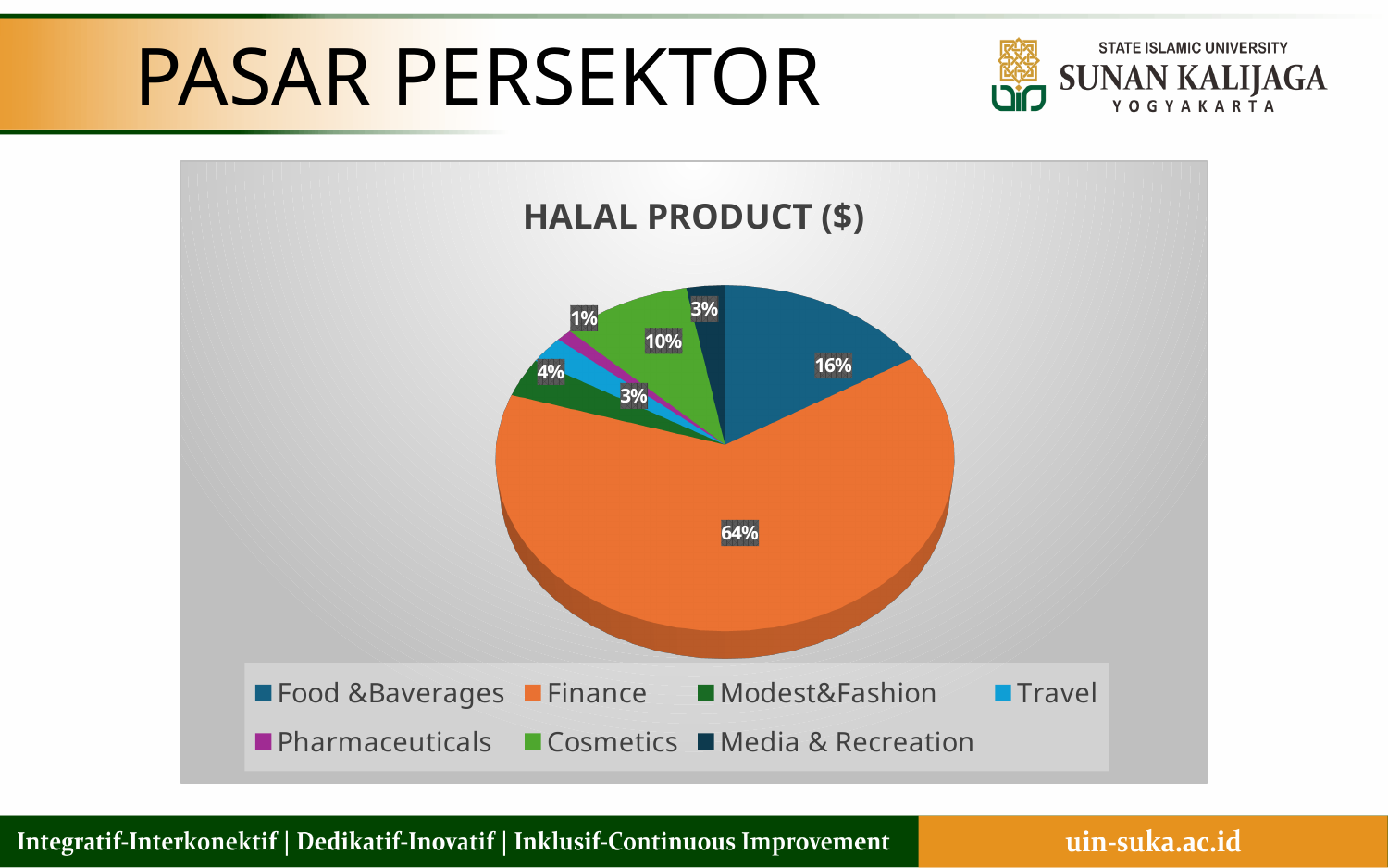
What share of the pie does Food &Baverages have? 16% Which category has the largest slice of the pie? Finance What share of the pie does Finance have? 64% What share of the pie does Cosmetics have? 10% What is the difference in percentage points between Finance and Food &Baverages? 48 Which is larger, the share for Cosmetics or the share for Modest&Fashion? Cosmetics How many categories does the legend list? 7 What share of the pie does Modest&Fashion have? 4% What share of the pie does Pharmaceuticals have? 1% Which category has the smallest slice of the pie? Pharmaceuticals What is the title of the chart? HALAL PRODUCT ($) What type of chart is shown on the slide? Pie chart